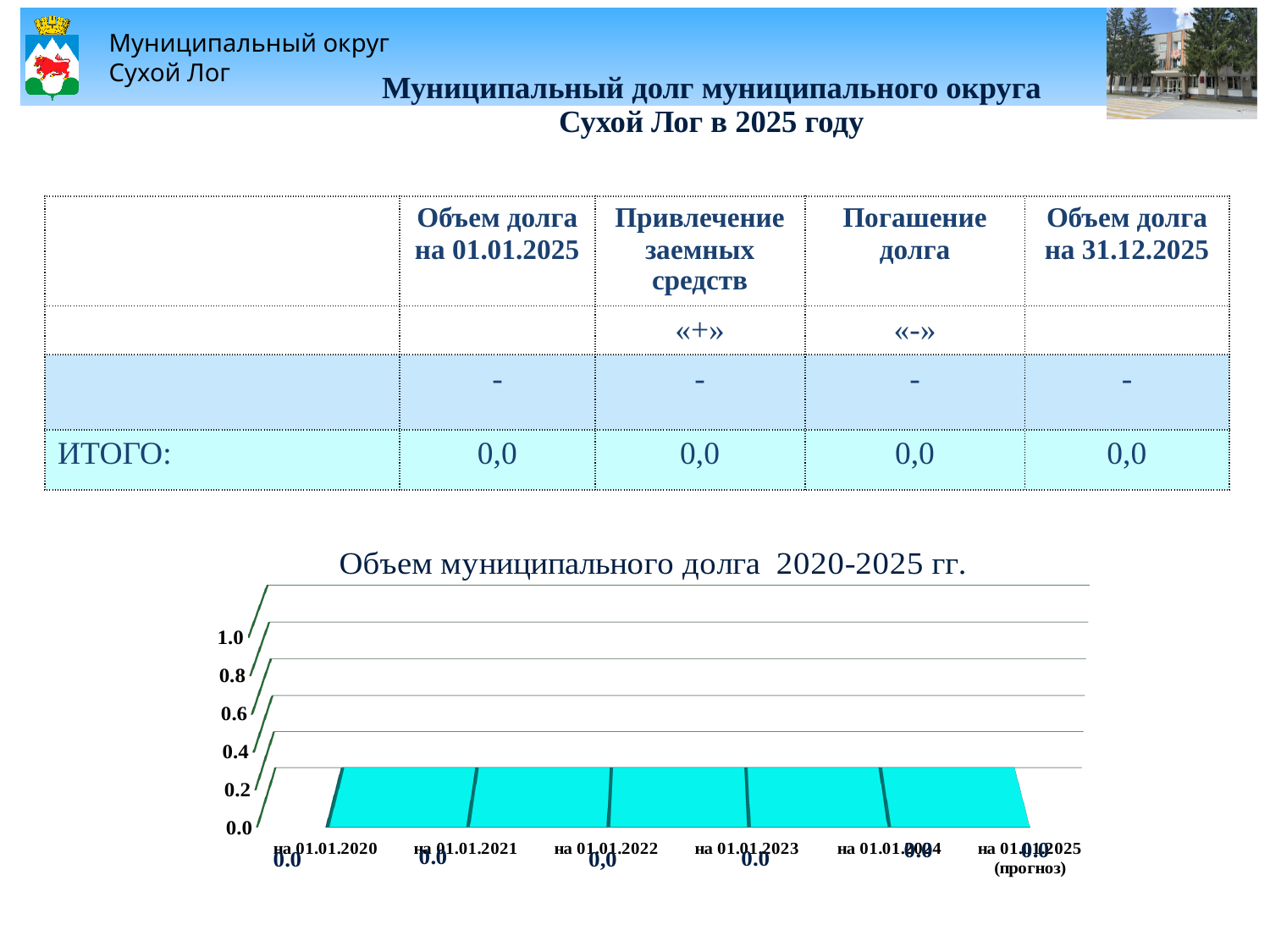
What is the value for на 01.01.2020 in the chart? 0.0 How many categories are plotted on the x axis of the chart? 6 What is the title of the chart on the slide? Объем муниципального долга 2020-2025 гг. What is the difference between the values for на 01.01.2025 (прогноз) and на 01.01.2020? 0.0 What is the highest value shown on the chart's vertical axis? 1.0 Do the values rise, fall, or stay flat from на 01.01.2020 to на 01.01.2025 (прогноз)? stay flat Is the value for на 01.01.2024 greater or less than 0.4? less What is the value for на 01.01.2022 in the chart? 0,0 Is the value for на 01.01.2021 greater or less than 0.2? less What is the value for на 01.01.2023 in the chart? 0.0 What is the value for на 01.01.2025 (прогноз) in the chart? 0.0 What kind of chart is shown on the slide? line chart